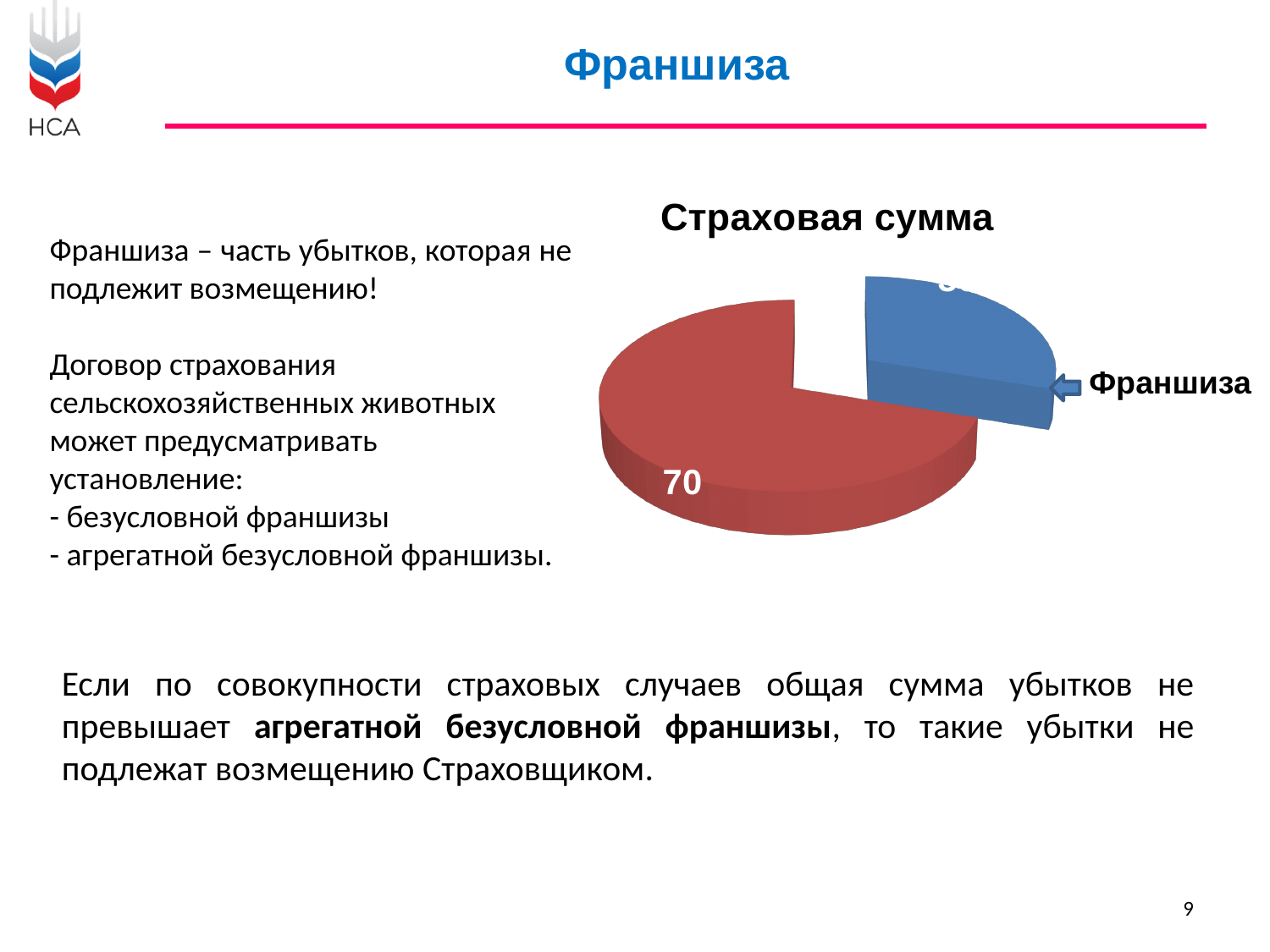
What value is printed on the red slice of the pie chart? 70 What kind of chart is shown on the slide? pie chart Is the value of the red slice in the pie chart greater or less than 50? greater How many slices does the pie chart have? 2 Which slice of the pie chart is larger, the red one or the blue one? the red one Which slice of the pie chart does the arrow labelled "Франшиза" point to? the blue slice What is the title of the pie chart on the slide? Страховая сумма Which slice of the pie chart is the smallest? the blue slice Which slice of the pie chart is the largest? the red slice (70)